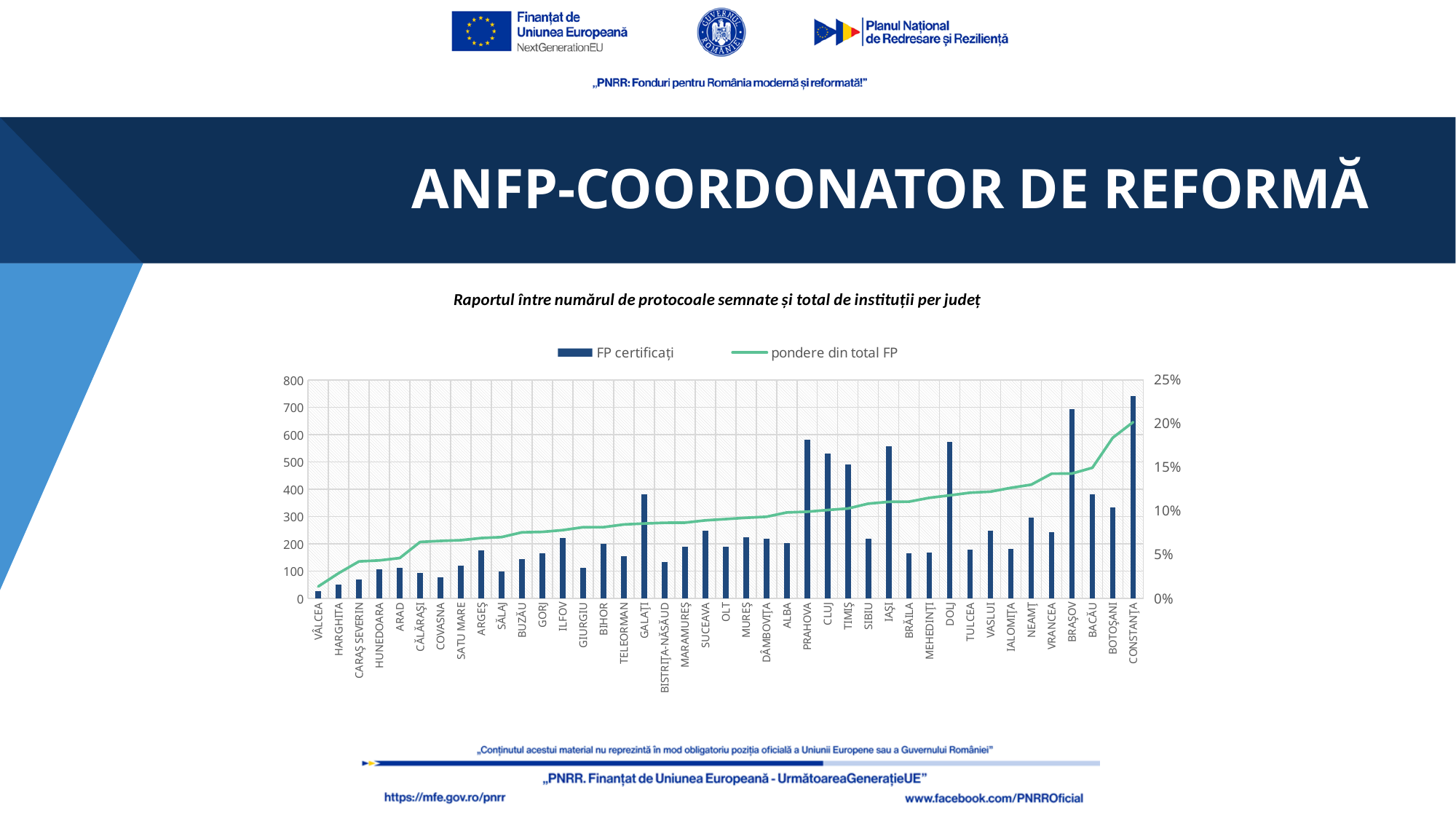
Which series is drawn as a line? pondere din total FP Is the FP certificați value for GALAȚI greater or less than 400? less Is the FP certificați value for PRAHOVA greater or less than 500? greater Is the FP certificați value for BRAȘOV greater or less than 600? greater How many series does the legend list? 2 What type of chart is shown on the slide? Combined bar and line chart Which has the larger FP certificați bar, CONSTANȚA or BRAȘOV? CONSTANȚA How many counties are shown on the x axis? 41 Does the pondere din total FP line rise or fall from VÂLCEA to CONSTANȚA? rise Which county has the lowest FP certificați bar? VÂLCEA Which county has the highest FP certificați bar? CONSTANȚA